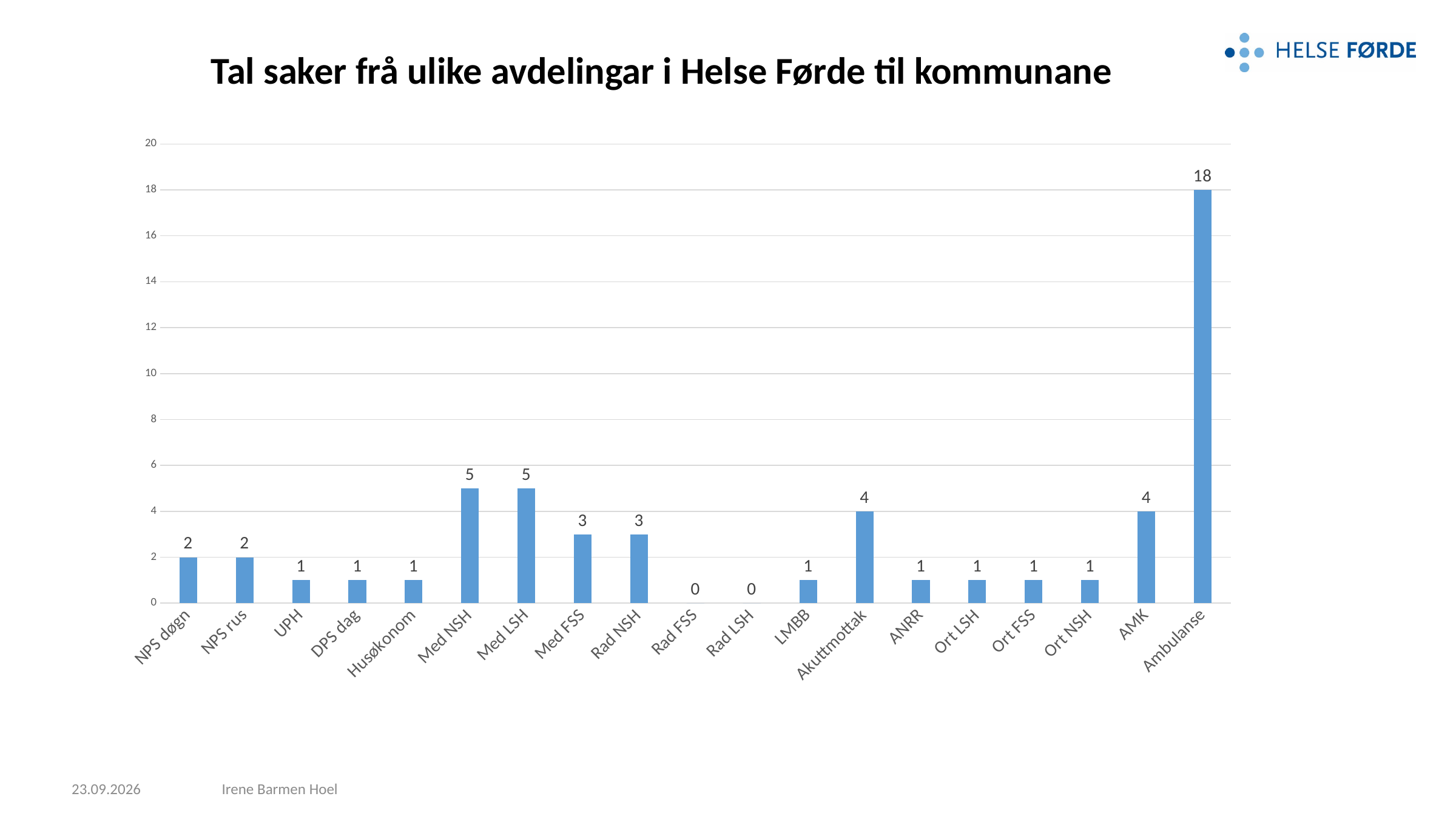
What is the difference between the values for Ambulanse and AMK? 14 Which is larger, the value for Med LSH or the value for NPS rus? Med LSH What is the value for Akuttmottak? 4 What is the value for Rad FSS? 0 What is the value for Med FSS? 3 How many categories are shown on the x axis? 19 What kind of chart is shown on the slide? bar chart Is the value for Ambulanse greater or less than 10? greater What is the title of the chart? Tal saker frå ulike avdelingar i Helse Førde til kommunane Which category has the highest value? Ambulanse What is the difference between the values for Med NSH and Rad NSH? 2 What is the value for Ambulanse? 18